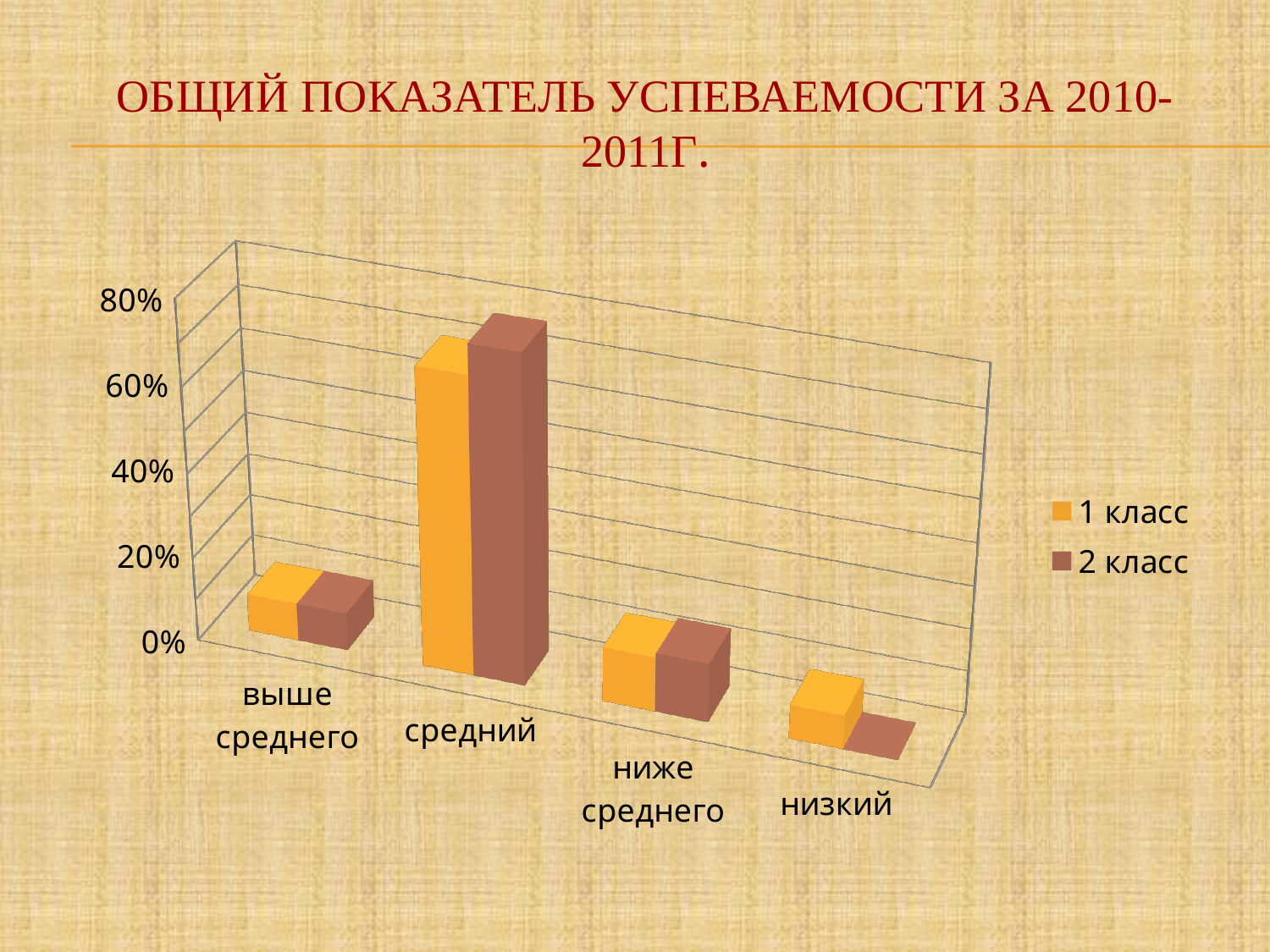
How many series does the legend list? 2 Which category has the highest value for 2 класс? средний Which category has the highest value for 1 класс? средний Is the value for ниже среднего for 2 класс greater or less than 40%? less Is the value for выше среднего for 1 класс greater or less than 20%? less Is the value for средний for 1 класс greater or less than 40%? greater For 1 класс, which is larger: the value for средний or the value for низкий? средний Which category has the lowest value for 2 класс? низкий What kind of chart is shown on the slide? bar chart What is the title of the chart on the slide? ОБЩИЙ ПОКАЗАТЕЛЬ УСПЕВАЕМОСТИ ЗА 2010-2011Г. Which series is shown in orange in the legend? 1 класс How many categories are shown on the x axis of the chart? 4